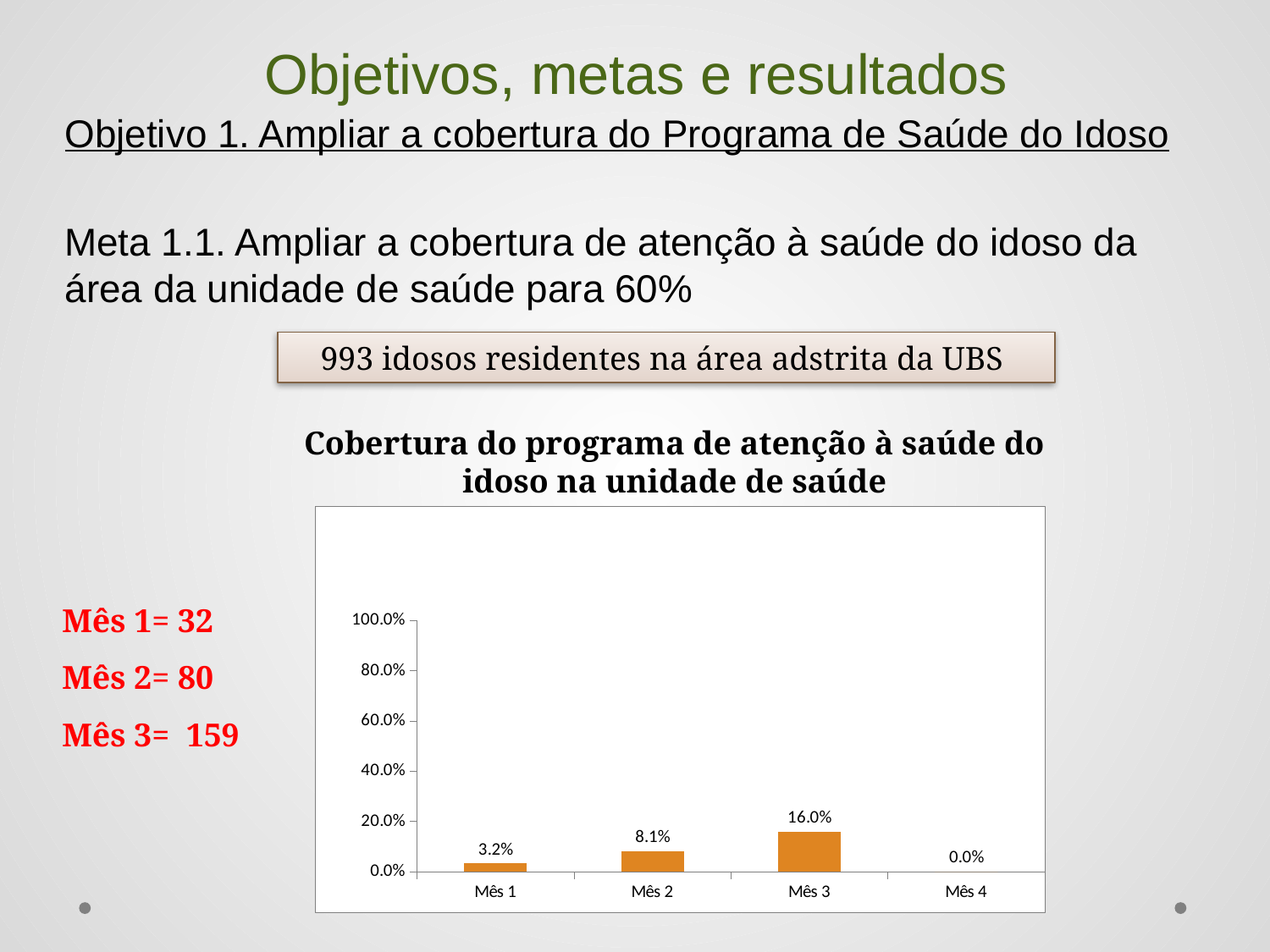
What is the title of the chart? Cobertura do programa de atenção à saúde do idoso na unidade de saúde What is the value for Mês 3? 16.0% What kind of chart is shown on the slide? bar chart How many months are shown on the x axis of the chart? 4 What is the difference between the values for Mês 3 and Mês 2? 7.9% Which is larger, the value for Mês 1 or the value for Mês 2? Mês 2 Is the value for Mês 3 greater or less than 20.0%? less Which month has the lowest coverage value? Mês 4 Which month has the highest coverage value? Mês 3 What is the value for Mês 1? 3.2% What is the value for Mês 2? 8.1% What is the value for Mês 4? 0.0%